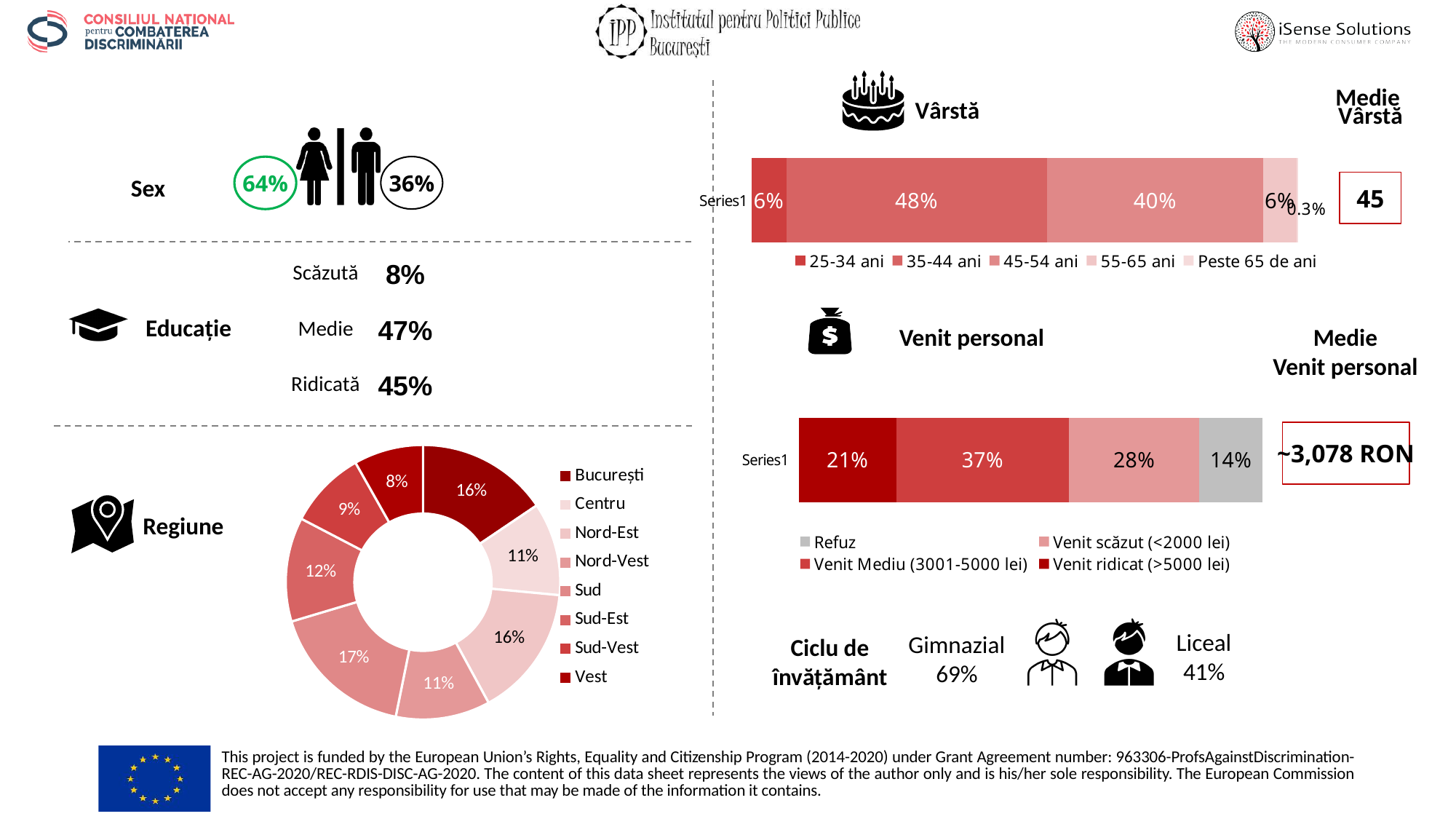
In the Vârstă chart, what percentage is shown for the 35-44 ani segment? 48% How many age groups does the legend of the Vârstă chart list? 5 In the Vârstă chart, what is the difference between the 35-44 ani and 45-54 ani shares? 8 percentage points In the Vârstă chart, which age group has the smallest share? Peste 65 de ani In the Venit personal chart, what is the total of all segments in the bar? 100% In the Regiune chart, which region has the largest share? Sud In the Regiune chart, what share is shown for Sud-Est? 12% How many regions are shown in the Regiune chart? 8 In the Venit personal chart, what percentage is shown for Refuz? 14% In the Vârstă chart, which age group has the largest share? 35-44 ani In the Venit personal chart, which income category has the largest share? Venit Mediu (3001-5000 lei) What kind of chart is the Venit personal chart? Stacked bar chart